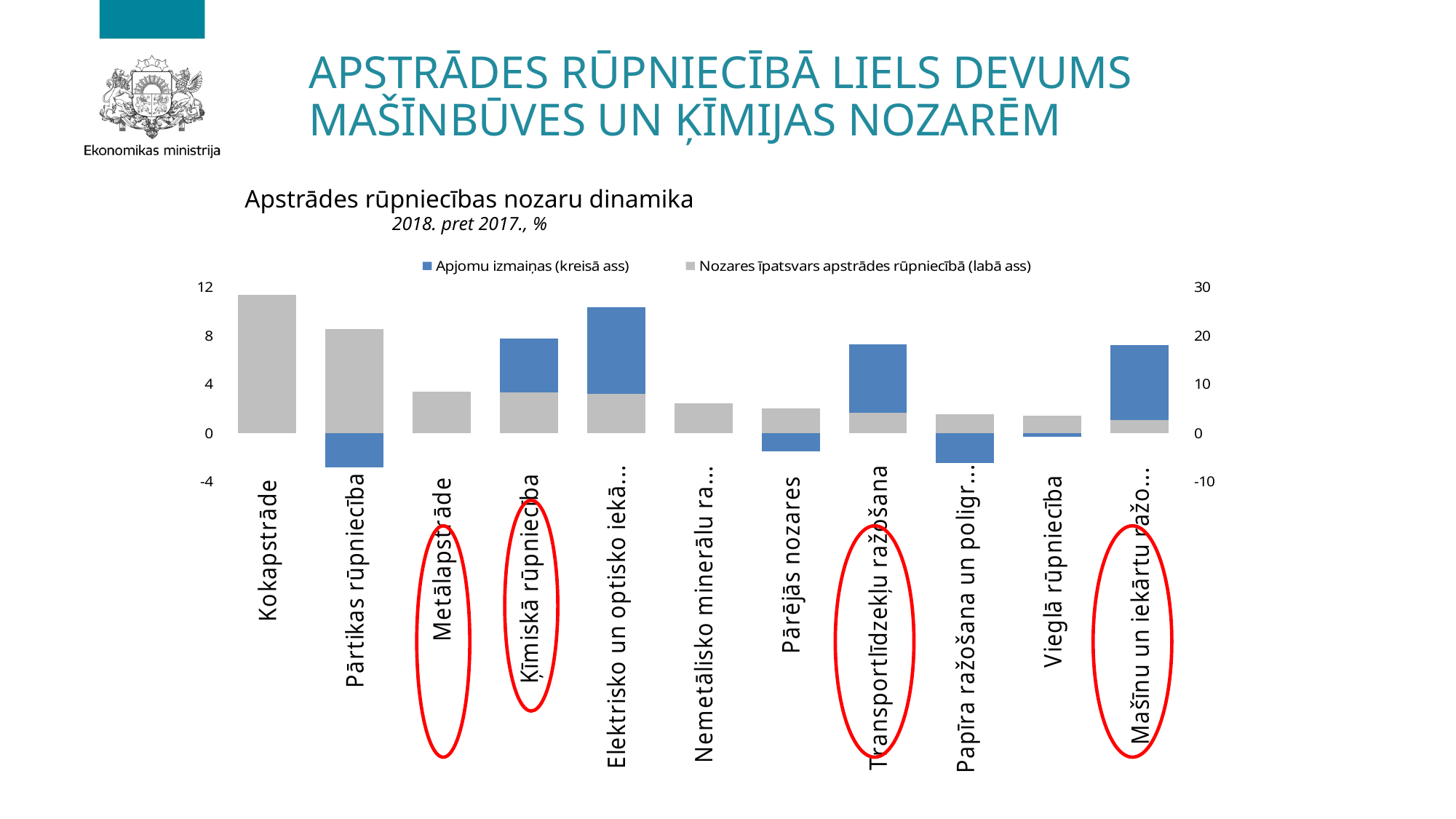
Do the grey Nozares īpatsvars bars generally rise or fall from left to right along the x axis? fall Which category has the lowest value for Apjomu izmaiņas (the blue series)? Pārtikas rūpniecība Which category has the highest value for Nozares īpatsvars apstrādes rūpniecībā (the grey series)? Kokapstrāde How many categories (industries) are shown on the x axis of the chart? 11 What kind of chart is shown on the slide? bar chart Which has the larger Nozares īpatsvars (grey bar): Kokapstrāde or Pārtikas rūpniecība? Kokapstrāde Is the Apjomu izmaiņas value for Elektrisko un optisko iekā... greater or less than 8? greater Is the Nozares īpatsvars value for Kokapstrāde greater or less than 20 on the right axis? greater How many series does the chart's legend list? 2 Is the Apjomu izmaiņas value for Papīra ražošana un poligr... greater or less than 0? less What is the subtitle shown under the chart title 'Apstrādes rūpniecības nozaru dinamika'? 2018. pret 2017., % Which category has the highest value for Apjomu izmaiņas (the blue series)? Elektrisko un optisko iekā...